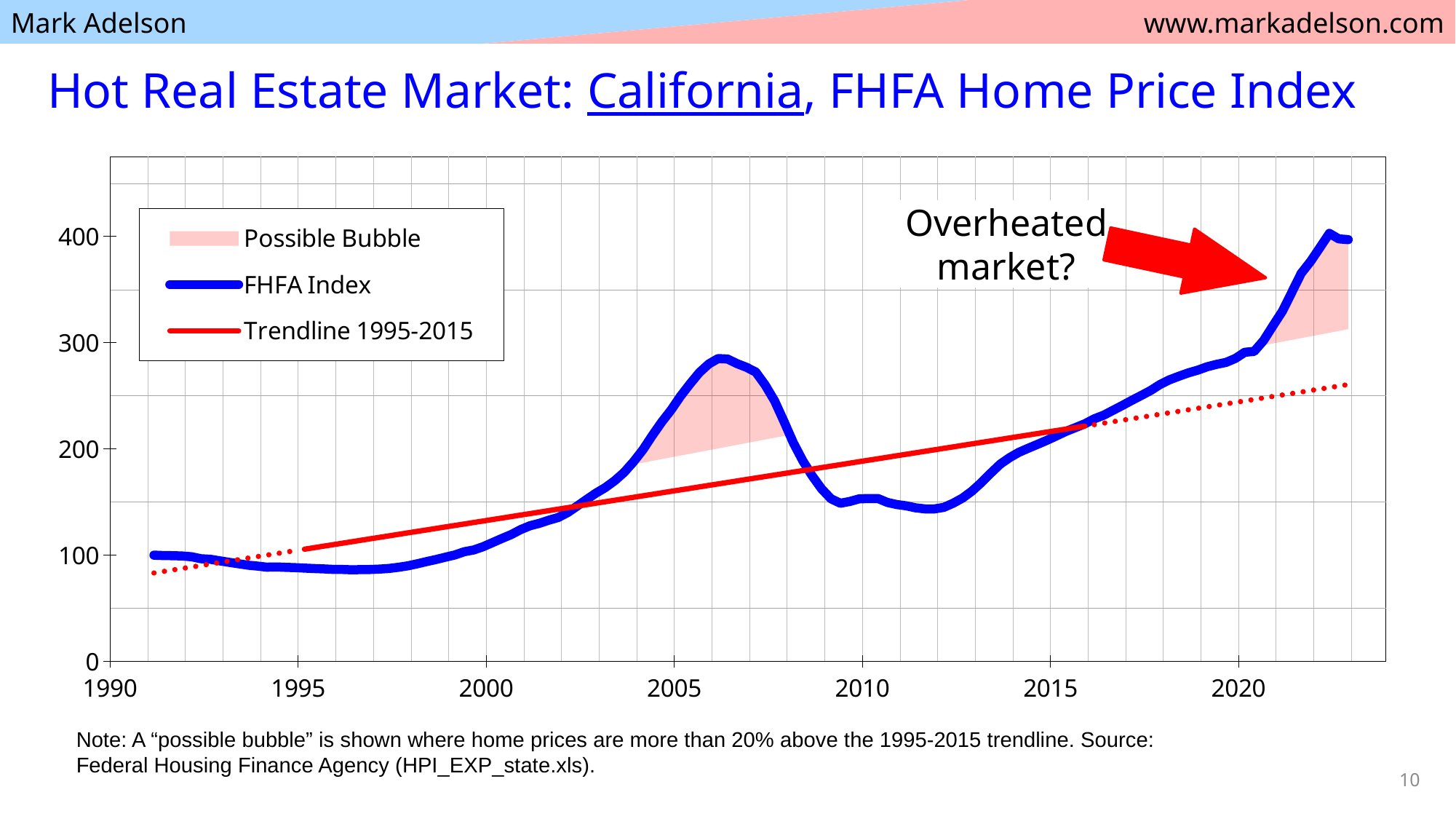
Is the FHFA Index value around 1997 greater or less than 100? less Which is higher for the FHFA Index: the peak around 2006 or the peak around 2022? the peak around 2022 Is the FHFA Index value around 2022 greater or less than 300? greater Around which year does the FHFA Index reach its highest value? 2022 Is the Trendline 1995-2015 value at 2005 greater or less than 200? less Overall, does the FHFA Index rise or fall from 1991 to 2023? rise What is the title of the slide's chart? Hot Real Estate Market: California, FHFA Home Price Index Which legend entry is drawn as a thick blue line? FHFA Index What kind of chart is shown on the slide? line chart How many entries does the chart legend list? 3